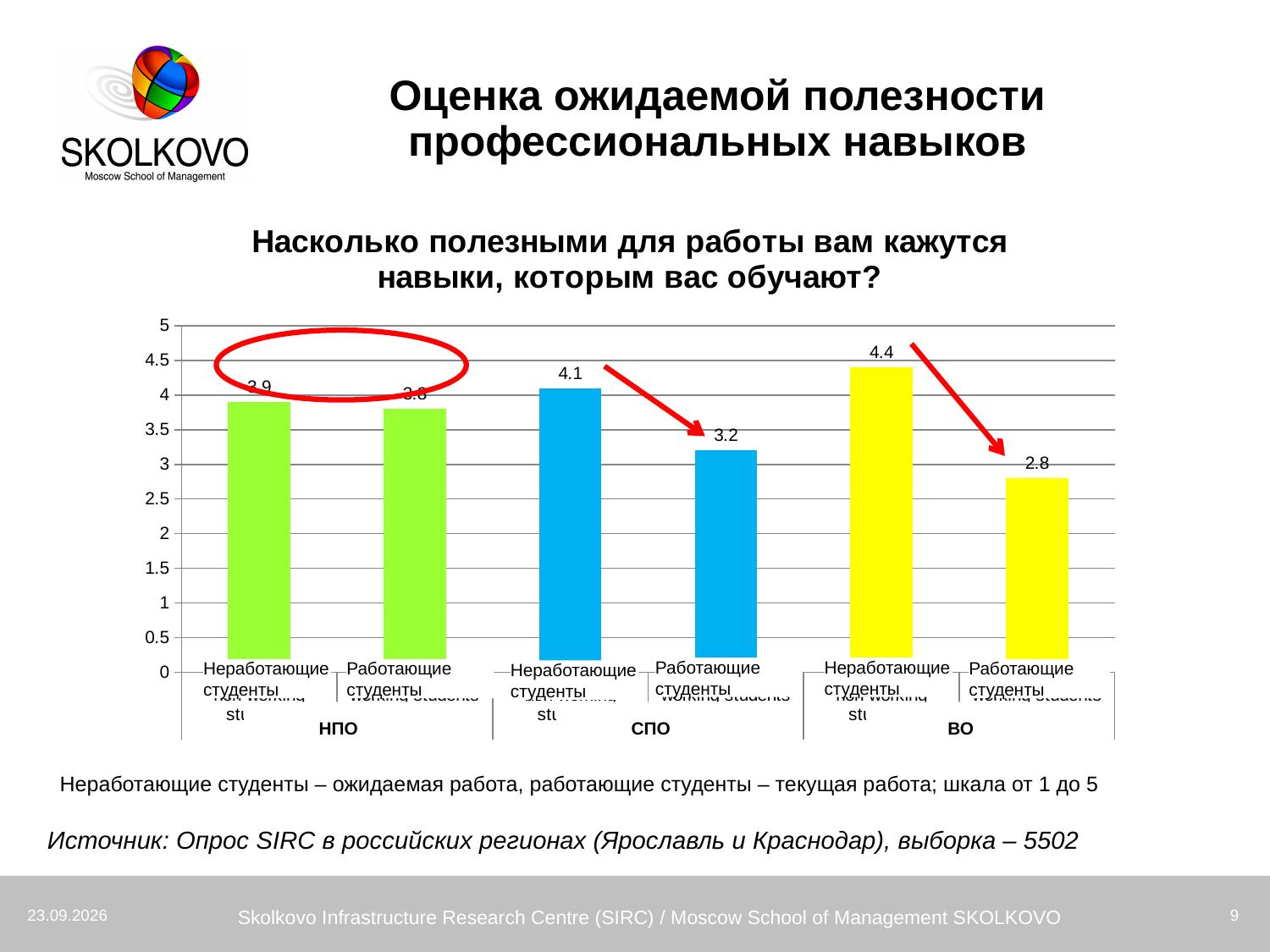
Which bar has the highest value in the chart? Неработающие студенты, ВО How many bars are plotted in the chart? 6 What is the value for Неработающие студенты in the СПО group? 4.1 Which is larger: Работающие студенты in СПО or Работающие студенты in ВО? Работающие студенты in СПО What is the value for Неработающие студенты in the НПО group? 3.9 What is the value for Неработающие студенты in the ВО group? 4.4 What is the difference between Неработающие студенты and Работающие студенты in the ВО group? 1.6 What is the value for Работающие студенты in the ВО group? 2.8 What is the value for Работающие студенты in the СПО group? 3.2 What kind of chart is shown on the slide? bar chart Is the value for Работающие студенты in the НПО group greater or less than 4? less Which bar has the lowest value in the chart? Работающие студенты, ВО